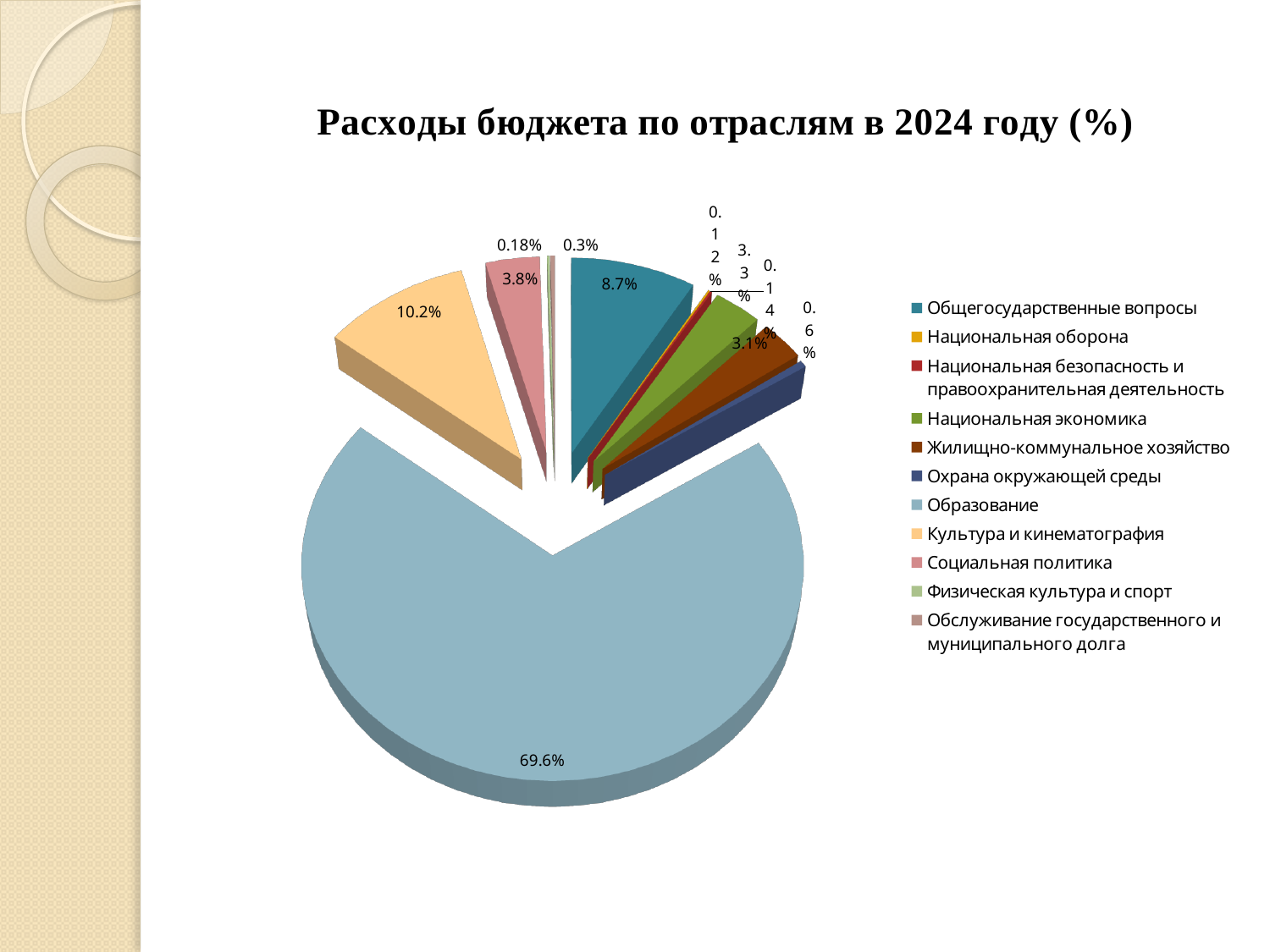
What share of the budget goes to Культура и кинематография? 10.2% What is the difference between the shares for Образование and Общегосударственные вопросы? 60.9% Which category has the largest share of the pie? Образование What is the difference between the shares for Культура и кинематография and Социальная политика? 6.4% What kind of chart is shown on the slide? pie chart Which is larger: the share for Культура и кинематография or the share for Социальная политика? Культура и кинематография How many categories does the legend list? 11 What share of the budget goes to Социальная политика? 3.8% Which is larger: the share for Общегосударственные вопросы or the share for Культура и кинематография? Культура и кинематография What share of the budget goes to Общегосударственные вопросы? 8.7% What is the title of the chart? Расходы бюджета по отраслям в 2024 году (%) What share of the budget goes to Образование? 69.6%